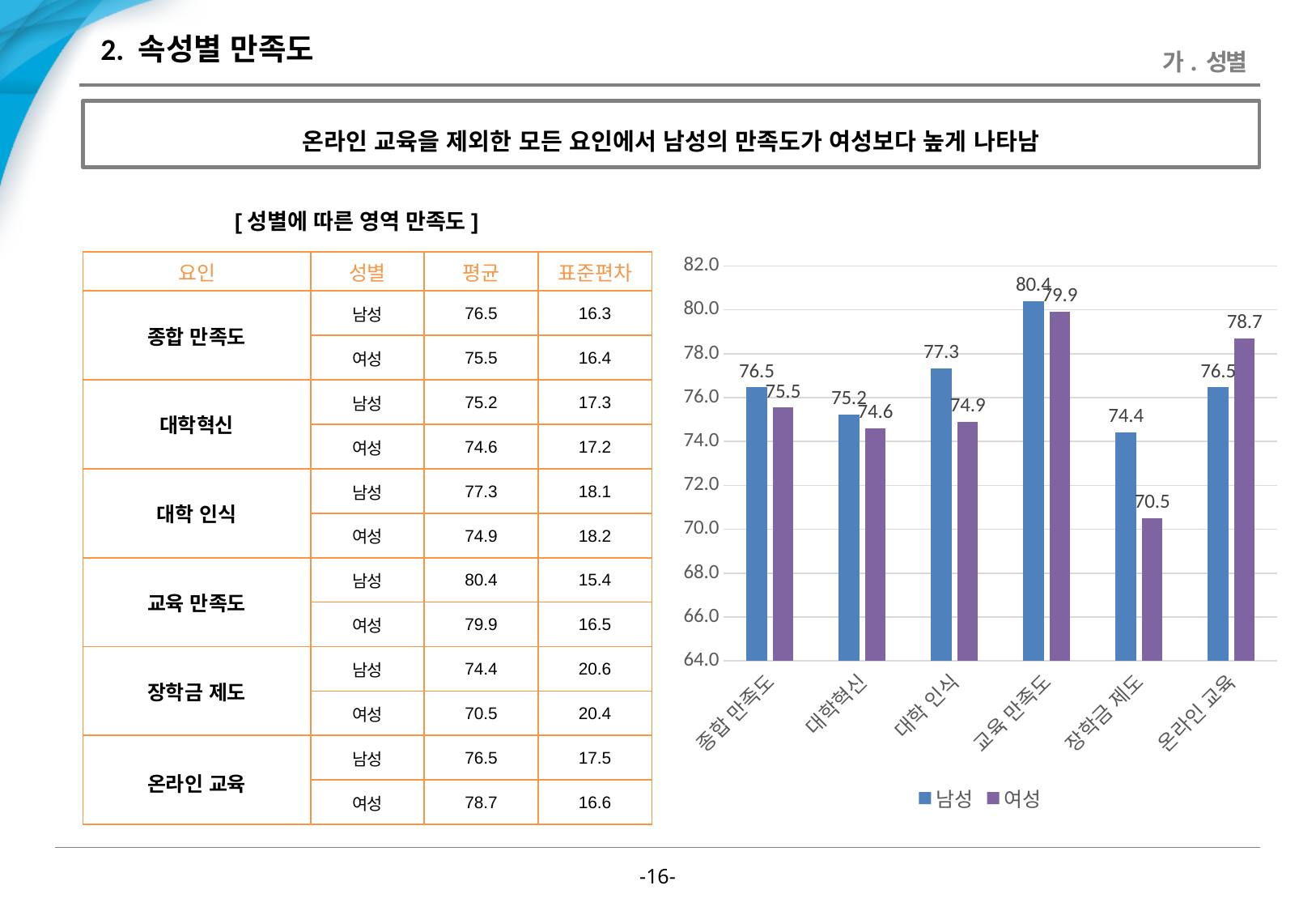
Is the value for 여성 in the 대학혁신 category greater or less than 76.0? less Which category has the highest value for 남성? 교육 만족도 What is the value for 여성 in the 장학금 제도 category? 70.5 What kind of chart is shown on the slide? bar chart In the 온라인 교육 category, which is larger, the 남성 value or the 여성 value? 여성 How many series does the chart legend list? 2 Which category has the lowest value for 여성? 장학금 제도 What are the two series names listed in the chart legend? 남성, 여성 What is the value for 남성 in the 교육 만족도 category? 80.4 What is the difference between the 남성 and 여성 values in the 장학금 제도 category? 3.9 How many categories are shown on the x axis of the chart? 6 What is the value for 여성 in the 온라인 교육 category? 78.7